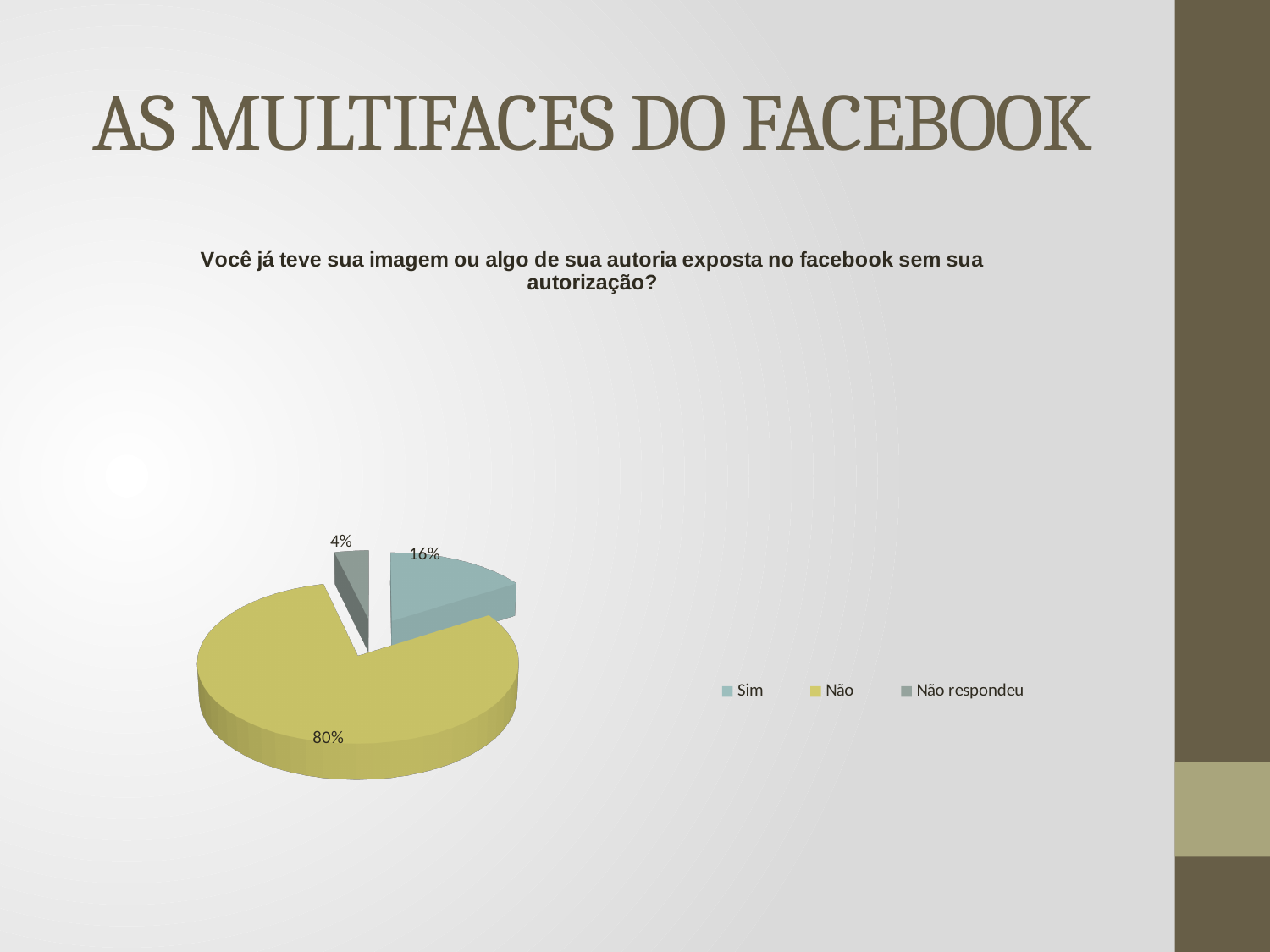
Which category has the smallest slice of the pie? Não respondeu What is the difference in percentage points between "Não" and "Sim"? 64 What is the difference in percentage points between "Sim" and "Não respondeu"? 12 What share of the pie does "Não" represent? 80% What share of the pie does "Sim" represent? 16% Which legend entry is shown in yellow-green? Não What share of the pie does "Não respondeu" represent? 4% Which category has the largest slice of the pie? Não Which is larger, the share for "Sim" or the share for "Não respondeu"? Sim How many categories does the pie chart have? 3 What is the title of the chart? Você já teve sua imagem ou algo de sua autoria exposta no facebook sem sua autorização? What kind of chart is shown on the slide? pie chart